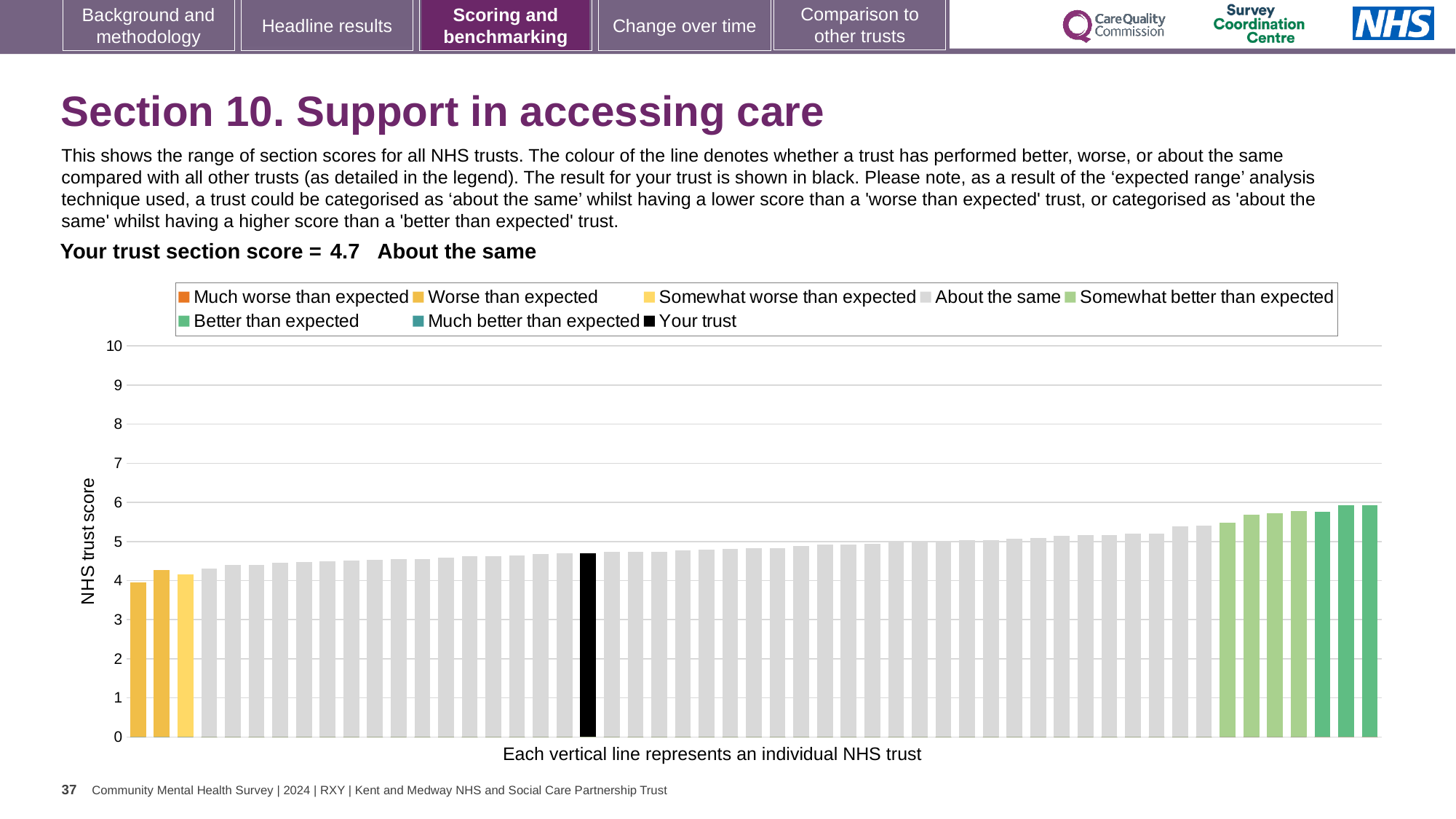
How many entries does the chart legend list? 8 Which is larger: the value of the rightmost bar or the value of your trust's black bar? the rightmost bar Is the value of the leftmost bar greater or less than 5? less What kind of chart is shown on the slide? bar chart Is the value for your trust (the black bar) greater or less than 5? less Which category is your trust's section score placed in, according to the slide? About the same Is the value of the rightmost bar greater or less than 5? greater How many bars are coloured as 'Worse than expected' (yellow)? 2 What is the section score for your trust shown on the slide? 4.7 Do the bar values rise or fall from left to right along the x axis? rise What is the label on the vertical axis of the chart? NHS trust score